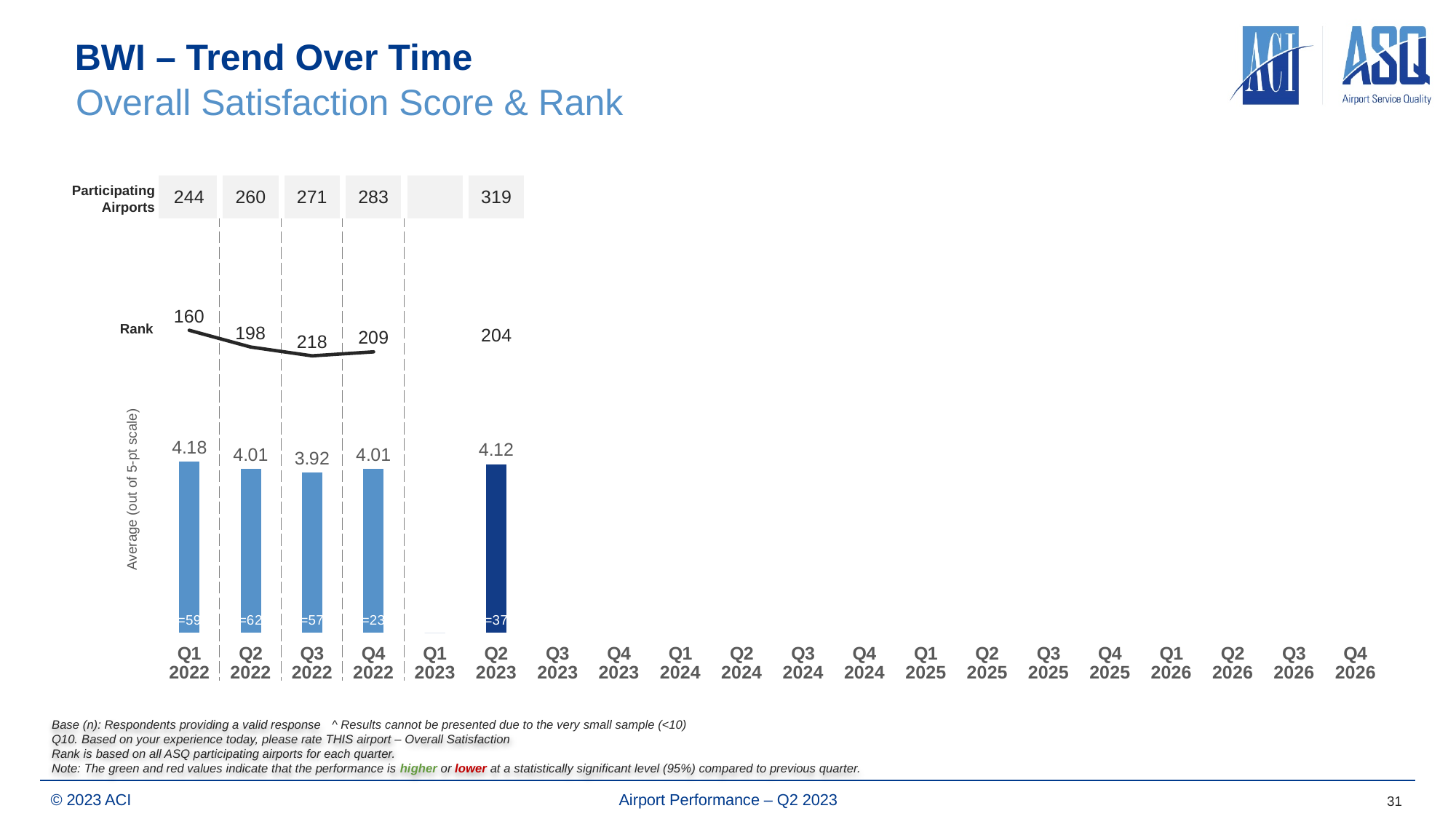
What is BWI's rank in Q3 2022? 218 What kind of chart is used to show the overall satisfaction scores? bar chart How many quarters have an overall satisfaction score bar plotted? 5 Which quarter has the lowest overall satisfaction score? Q3 2022 What is the overall satisfaction score for Q2 2023? 4.12 What is the overall satisfaction score for Q3 2022? 3.92 Which quarter has the highest overall satisfaction score? Q1 2022 What is the difference between the overall satisfaction scores for Q1 2022 and Q3 2022? 0.26 Which is larger, the overall satisfaction score for Q2 2023 or for Q4 2022? Q2 2023 How many participating airports were there in Q2 2023? 319 What is the overall satisfaction score for Q1 2022? 4.18 What is BWI's rank in Q2 2023? 204